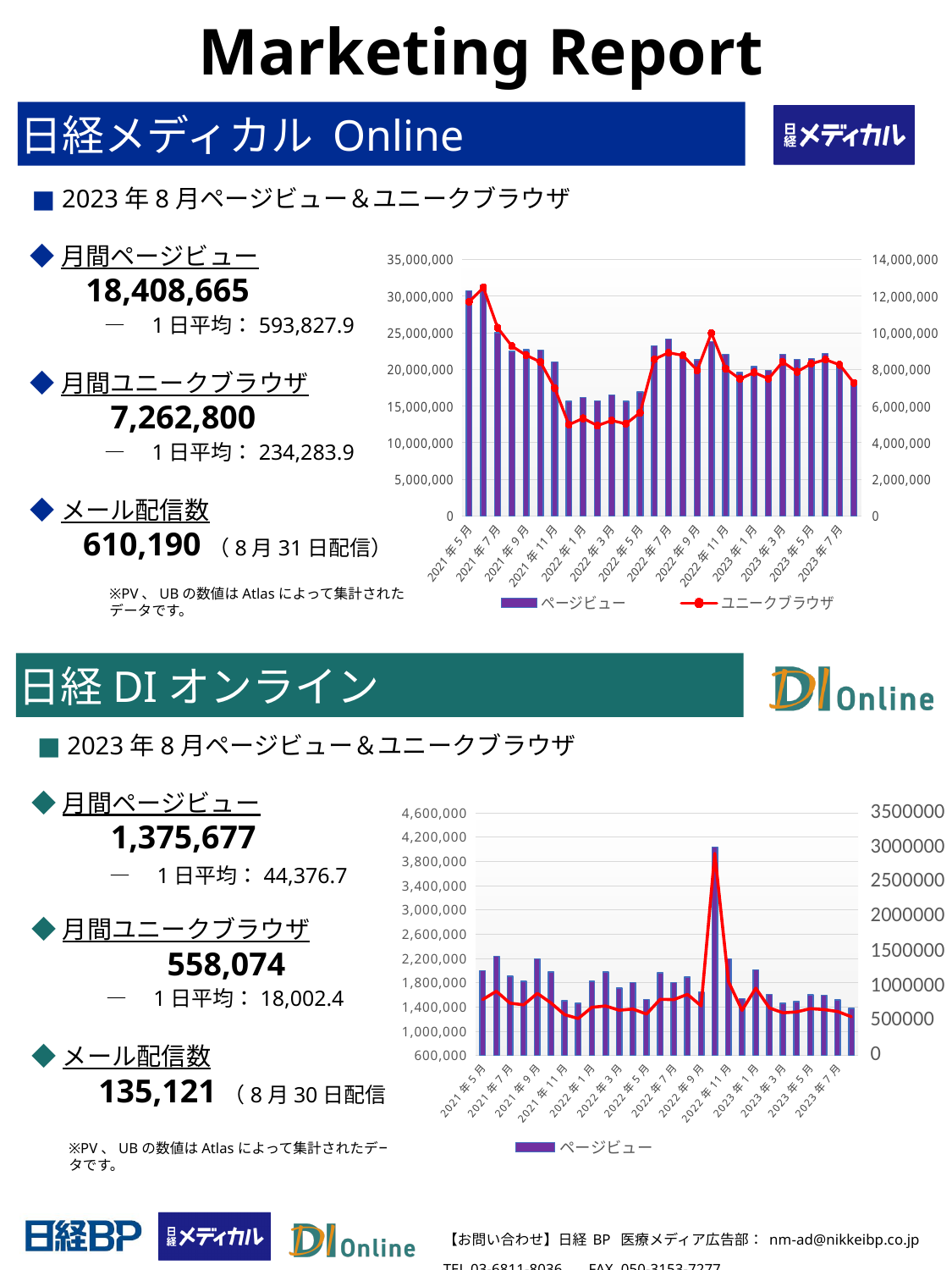
In the 日経メディカル Online chart, is the page view value for 2022年1月 greater or less than 20,000,000? less In the 日経メディカル Online chart, do page views rise or fall from 2021年5月 to 2022年1月? fall In the 日経DIオンライン chart, is the highest page view bar greater or less than 3,400,000? greater How many series does the legend of the 日経DIオンライン chart list? 1 In the 日経DIオンライン chart, is the page view value for 2021年5月 greater or less than 1,400,000? greater How many series does the legend of the 日経メディカル Online chart list? 2 What is the highest tick on the left axis of the 日経メディカル Online chart? 35,000,000 In the 日経メディカル Online chart, which series is drawn as a red line according to the legend? ユニークブラウザ How many month labels are shown on the x axis of the 日経DIオンライン chart? 14 What kind of chart is shown in the 日経メディカル Online section? A combined bar and line chart